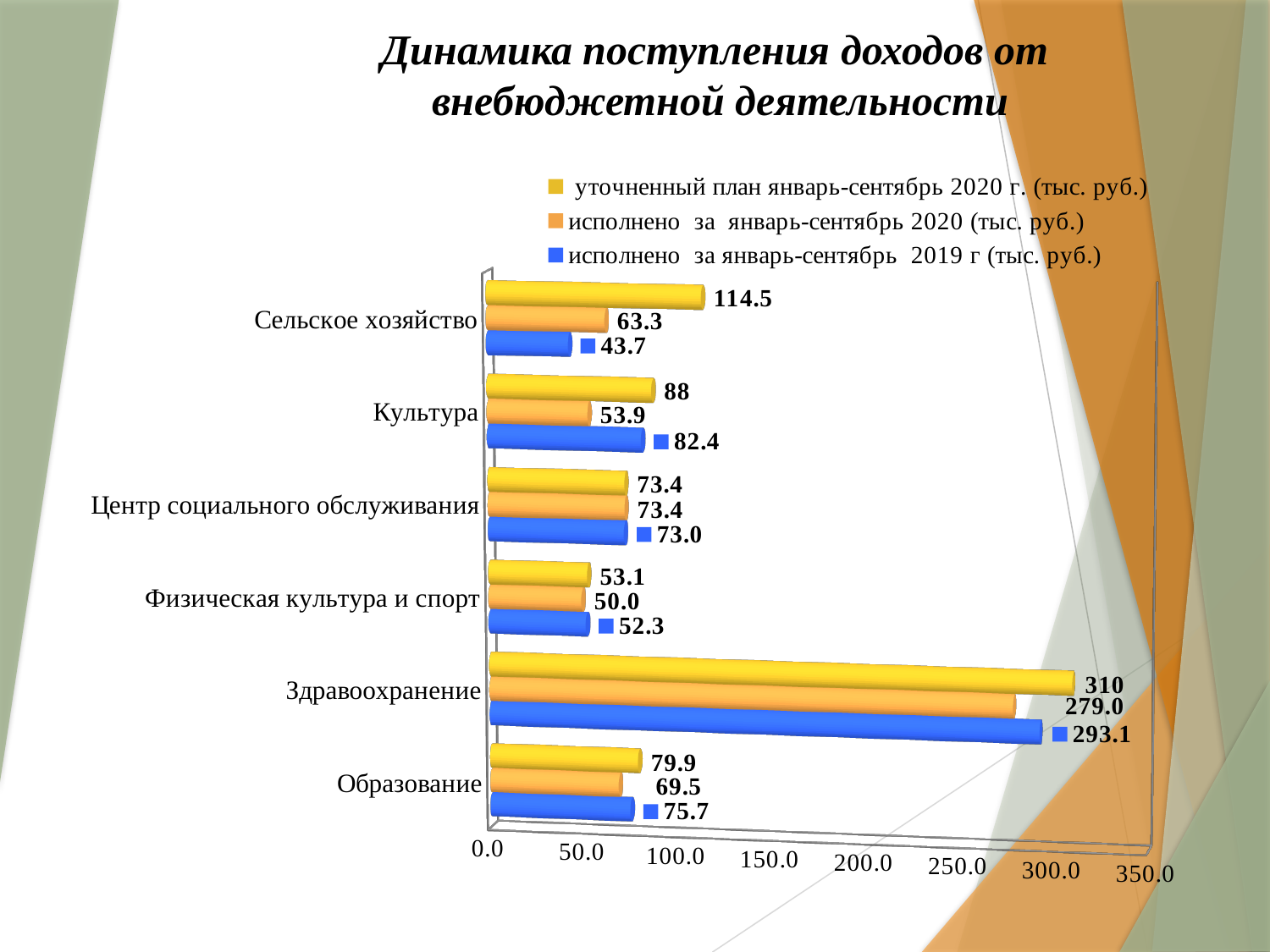
Which category has the highest value for 'уточненный план январь-сентябрь 2020 г.'? Здравоохранение How many series does the legend list? 3 What is the difference between 'уточненный план январь-сентябрь 2020 г.' and 'исполнено за январь-сентябрь 2020' for Образование? 10.4 Which category has the lowest value for 'исполнено за январь-сентябрь 2019 г'? Сельское хозяйство How many categories are shown on the chart? 6 What is the title of the chart on the slide? Динамика поступления доходов от внебюджетной деятельности What type of chart is shown on the slide? bar chart What is the value of 'исполнено за январь-сентябрь 2020' for Здравоохранение? 279.0 Is the value of 'исполнено за январь-сентябрь 2019 г' for Здравоохранение greater or less than 250.0? greater What is the value of 'исполнено за январь-сентябрь 2019 г' for Культура? 82.4 For Культура, which is larger: 'исполнено за январь-сентябрь 2020' or 'исполнено за январь-сентябрь 2019 г'? исполнено за январь-сентябрь 2019 г What is the value of 'уточненный план январь-сентябрь 2020 г.' for Сельское хозяйство? 114.5